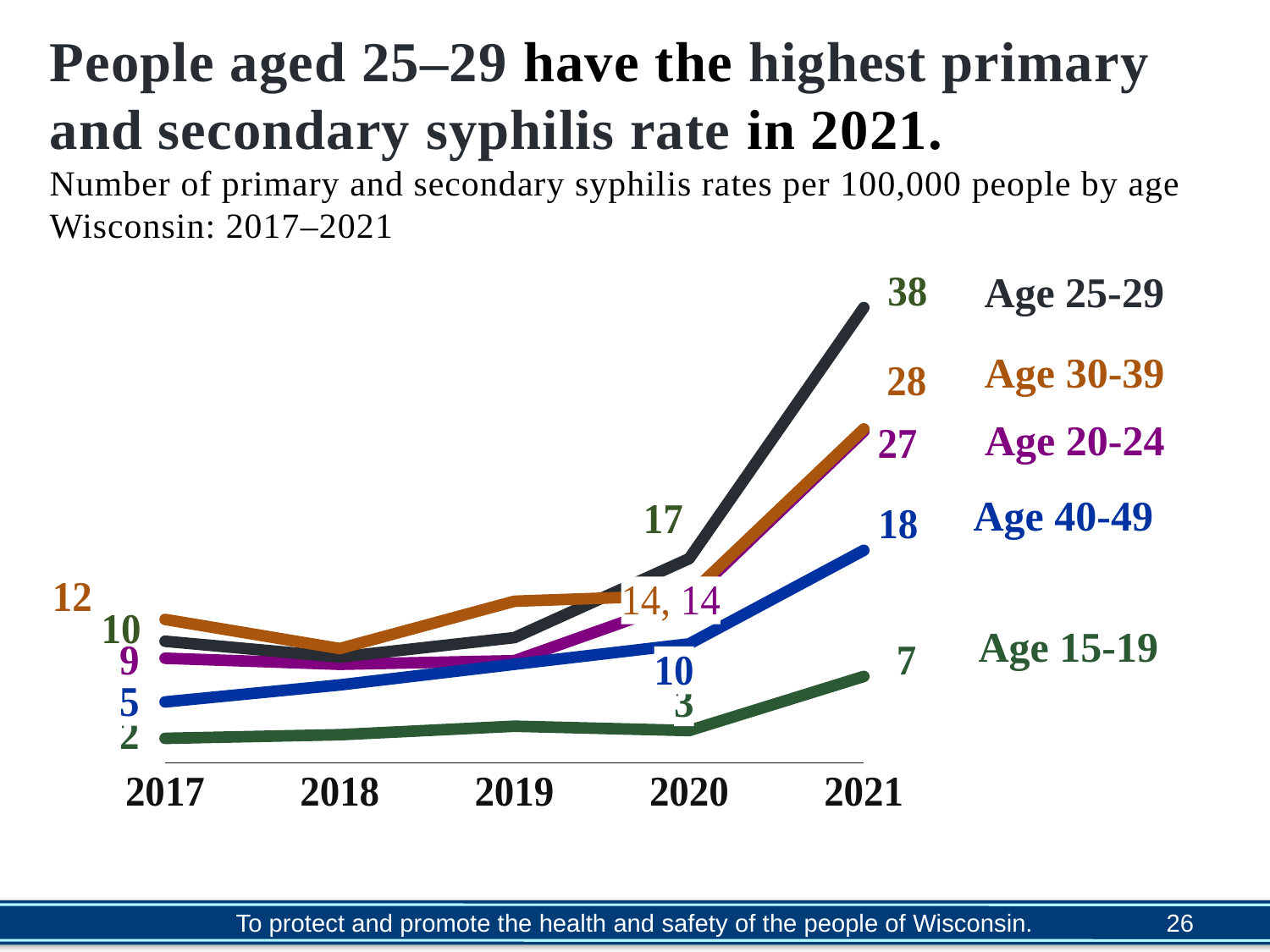
In 2021, which has the higher rate: Age 30-39 or Age 20-24? Age 30-39 What is the rate for Age 40-49 in 2017? 5 Which age group has the highest rate in 2021? Age 25-29 What is the rate for Age 25-29 in 2020? 17 By how much did the rate for Age 15-19 increase from 2017 to 2021? 5 How many years are shown on the x axis? 5 What is the primary and secondary syphilis rate for Age 25-29 in 2021? 38 What is the rate for Age 15-19 in 2021? 7 Which age group has the lowest rate in 2021? Age 15-19 What kind of chart is shown on the slide? Line chart How many age groups are listed in the legend? 5 What is the difference between the 2021 rates for Age 25-29 and Age 30-39? 10